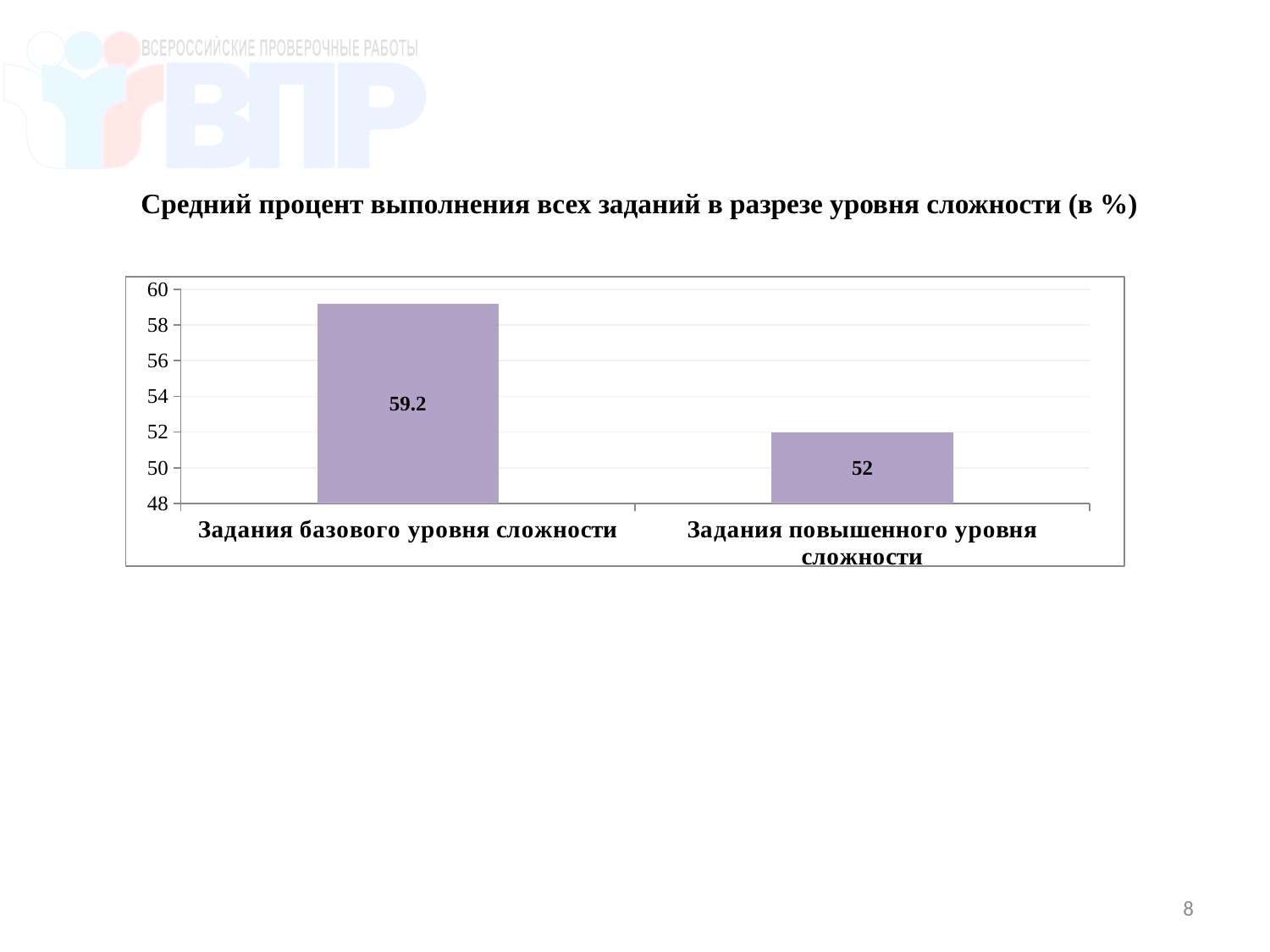
What is the title of the chart? Средний процент выполнения всех заданий в разрезе уровня сложности (в %) Which category has the highest value? Задания базового уровня сложности What is the value for Задания повышенного уровня сложности? 52 What is the value for Задания базового уровня сложности? 59.2 Is the value for Задания базового уровня сложности greater or less than 58? greater What kind of chart is shown on the slide? bar chart Do the values rise or fall from left to right along the x axis? fall How many categories are shown in the chart? 2 Which category has the lowest value? Задания повышенного уровня сложности Which is larger: the value for Задания базового уровня сложности or for Задания повышенного уровня сложности? Задания базового уровня сложности What is the difference between the values for Задания базового уровня сложности and Задания повышенного уровня сложности? 7.2 Is the value for Задания повышенного уровня сложности greater or less than 54? less